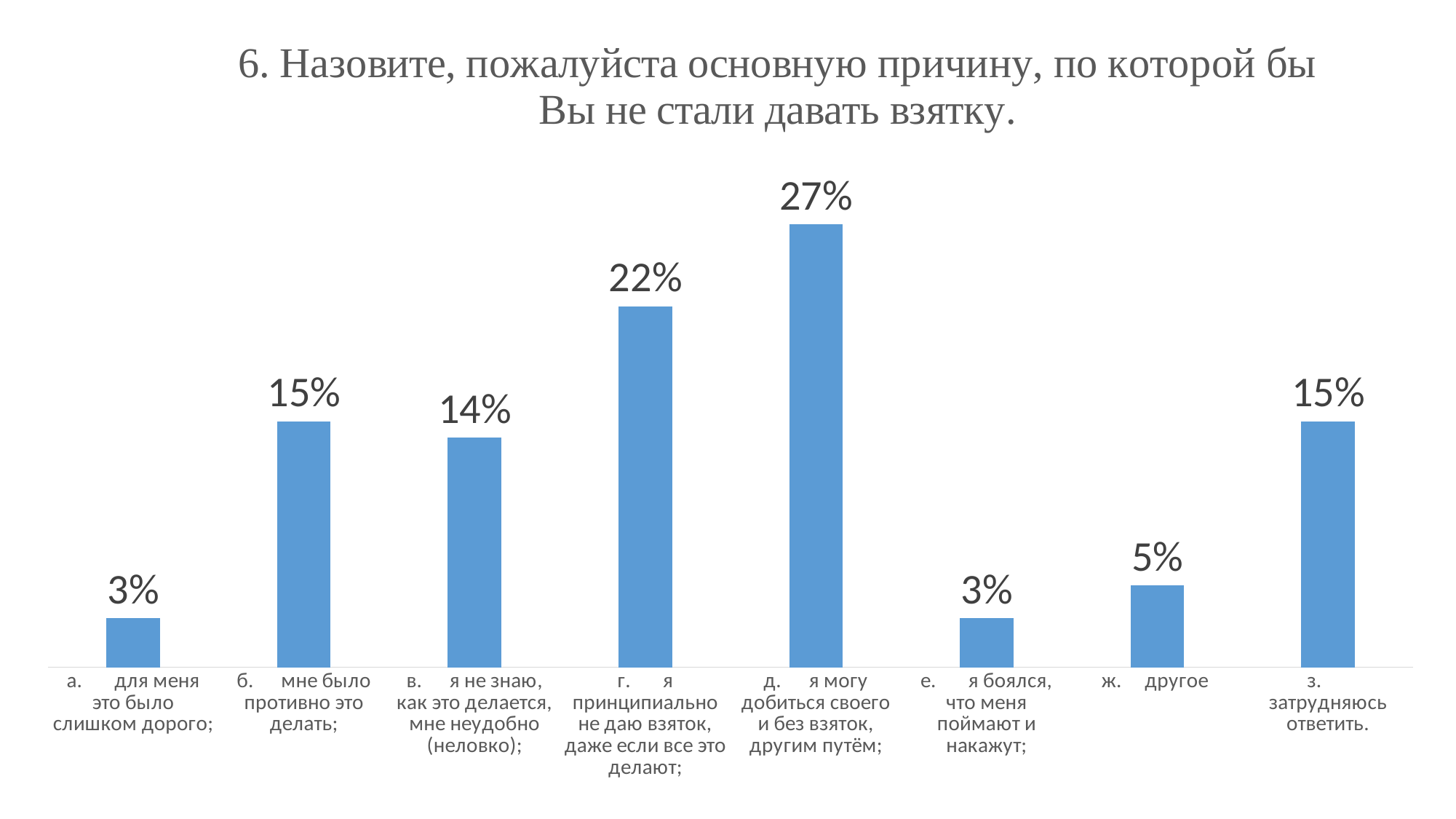
What kind of chart is shown on the slide? Bar chart What is the difference between the values for "д. я могу добиться своего и без взяток, другим путём" and "г. я принципиально не даю взяток, даже если все это делают"? 5% Which is larger: the value for "б. мне было противно это делать" or the value for "в. я не знаю, как это делается, мне неудобно (неловко)"? б. мне было противно это делать Which category has the highest value? д. я могу добиться своего и без взяток, другим путём What is the difference between the values for "з. затрудняюсь ответить" and "ж. другое"? 10% Which two categories share the lowest value of 3%? а. для меня это было слишком дорого; е. я боялся, что меня поймают и накажут What value is shown for "ж. другое"? 5% What value is shown for "в. я не знаю, как это делается, мне неудобно (неловко)"? 14% How many categories are shown on the chart? 8 What is the title of the chart? 6. Назовите, пожалуйста основную причину, по которой бы Вы не стали давать взятку. What percentage is shown for the category "д. я могу добиться своего и без взяток, другим путём"? 27% What is the lowest value shown on the chart? 3%